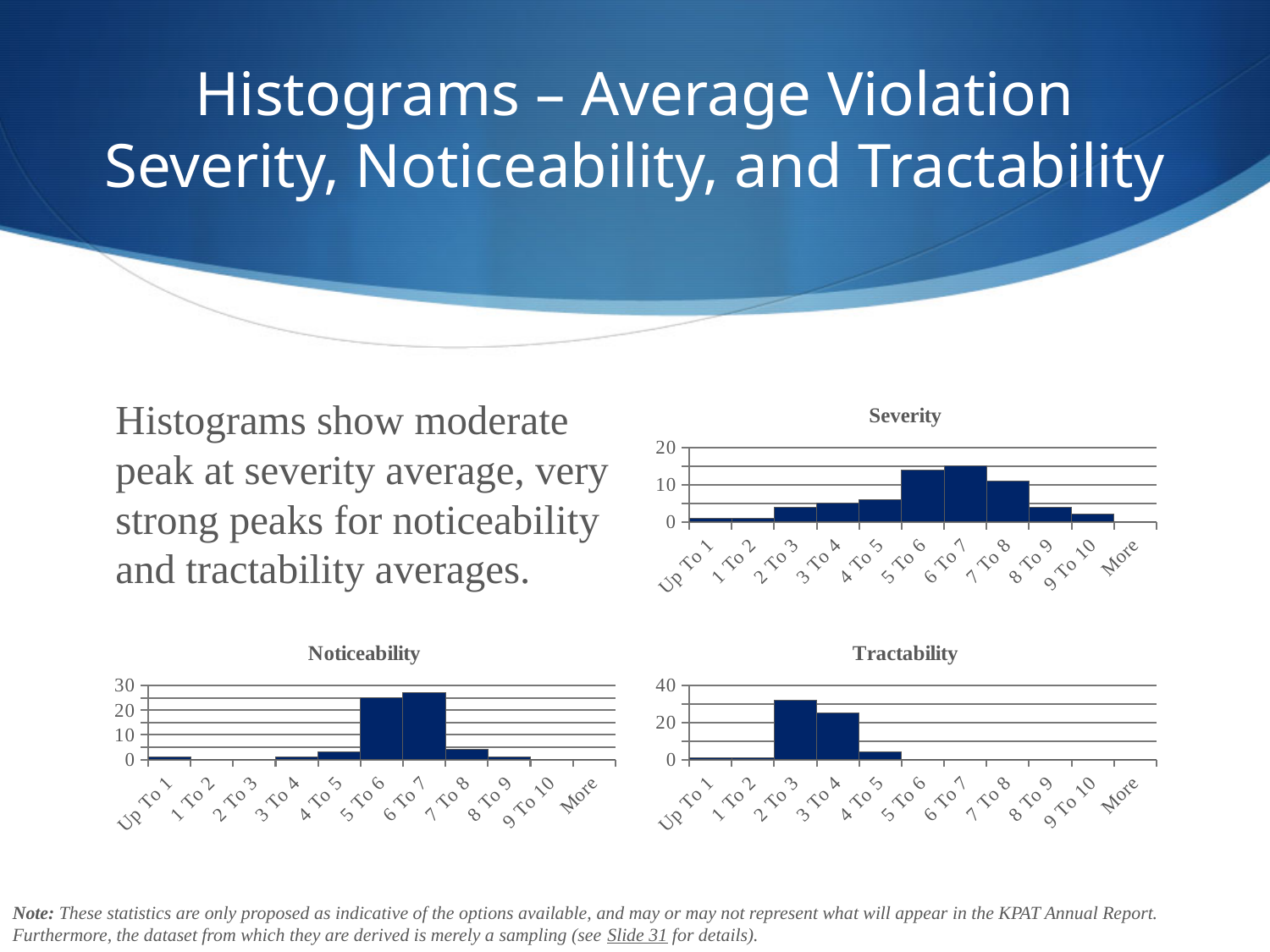
In the Tractability chart, which category has the highest value? 2 To 3 In the Severity chart, which is larger, the value for 6 To 7 or the value for 8 To 9? 6 To 7 What kind of chart is the Severity chart? bar chart In the Tractability chart, is the value for 4 To 5 greater or less than 20? less In the Severity chart, is the value for 6 To 7 greater or less than 10? greater In the Noticeability chart, is the value for 7 To 8 greater or less than 10? less In the Tractability chart, which is larger, the value for 2 To 3 or the value for 3 To 4? 2 To 3 What is the title of the chart at the bottom left of the slide? Noticeability How many categories are shown on the x axis of the Tractability chart? 11